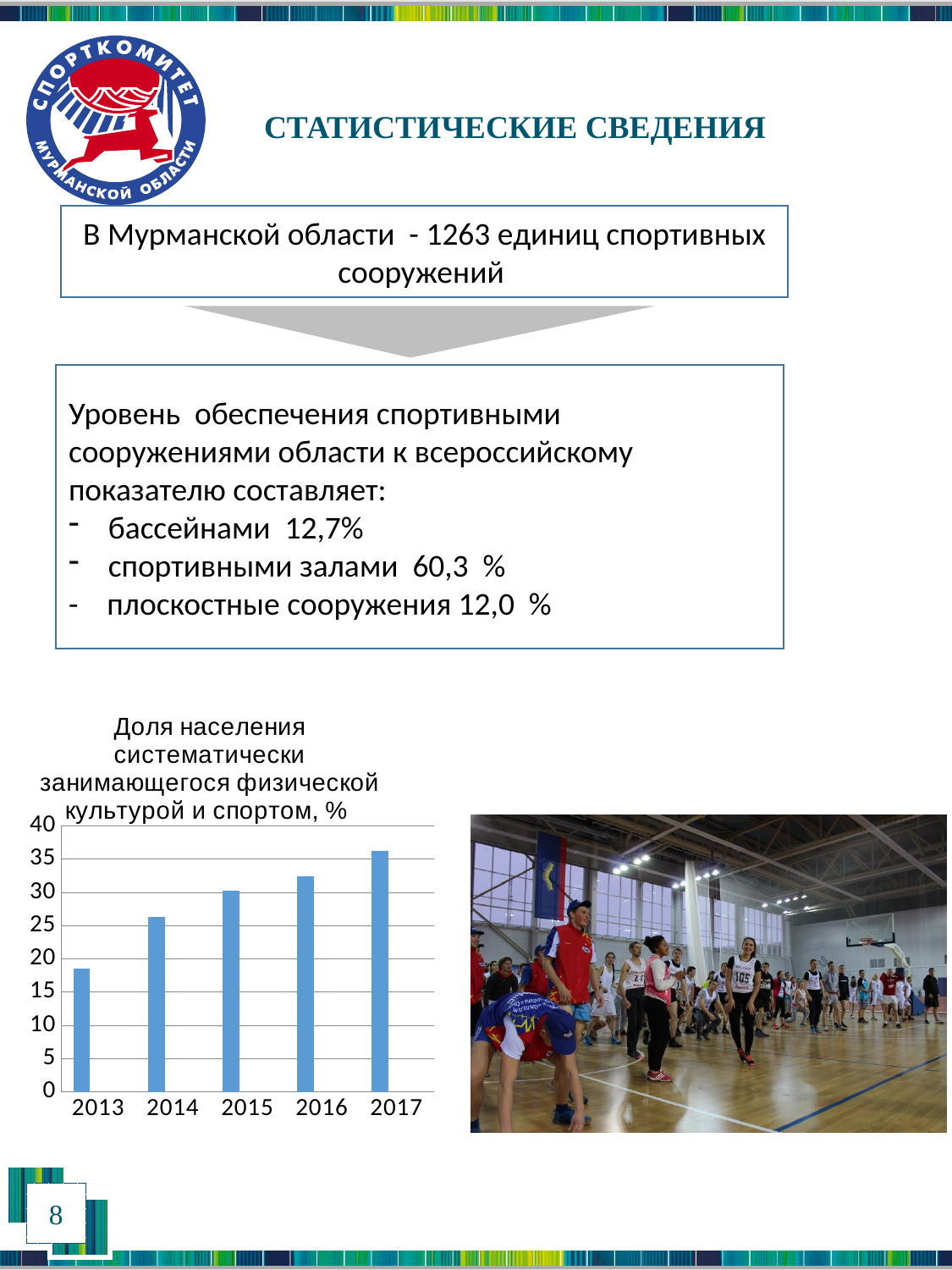
What is the title of the chart? Доля населения систематически занимающегося физической культурой и спортом, % Which year has the larger value, 2014 or 2016? 2016 Is the value for 2017 greater or less than 35? greater How many years are shown on the x axis of the chart? 5 Is the value for 2016 greater or less than 30? greater Which year has the lowest bar in the chart? 2013 Is the value for 2014 greater or less than 25? greater Which year has the highest bar in the chart? 2017 Do the values in the chart rise or fall from 2013 to 2017? rise What kind of chart is shown on the slide? bar chart